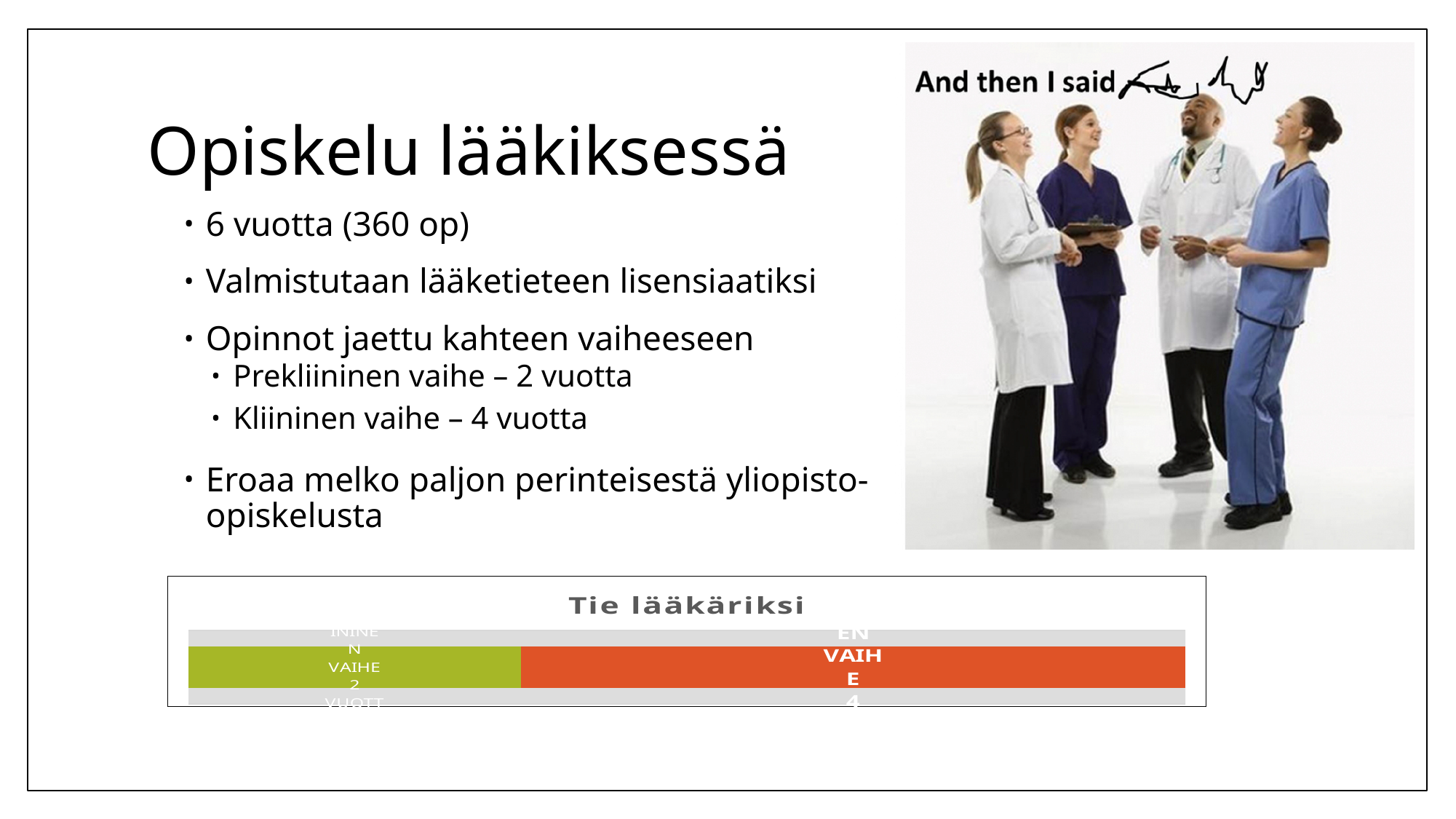
In the "Tie lääkäriksi" chart, what number is printed in the green segment? 2 What kind of chart is shown under the title "Tie lääkäriksi"? bar chart In the "Tie lääkäriksi" chart, which colour is the segment on the left side of the bar? green How many segments make up the bar in the "Tie lääkäriksi" chart? 2 In the "Tie lääkäriksi" chart, which segment is larger, the green one or the orange one? the orange one In the "Tie lääkäriksi" chart, what is the total of the two segment values (2 and 4)? 6 What is the title of the chart at the bottom of the slide? Tie lääkäriksi In the "Tie lääkäriksi" chart, what number is printed in the orange segment? 4 In the "Tie lääkäriksi" chart, what is the difference between the orange segment value and the green segment value? 2